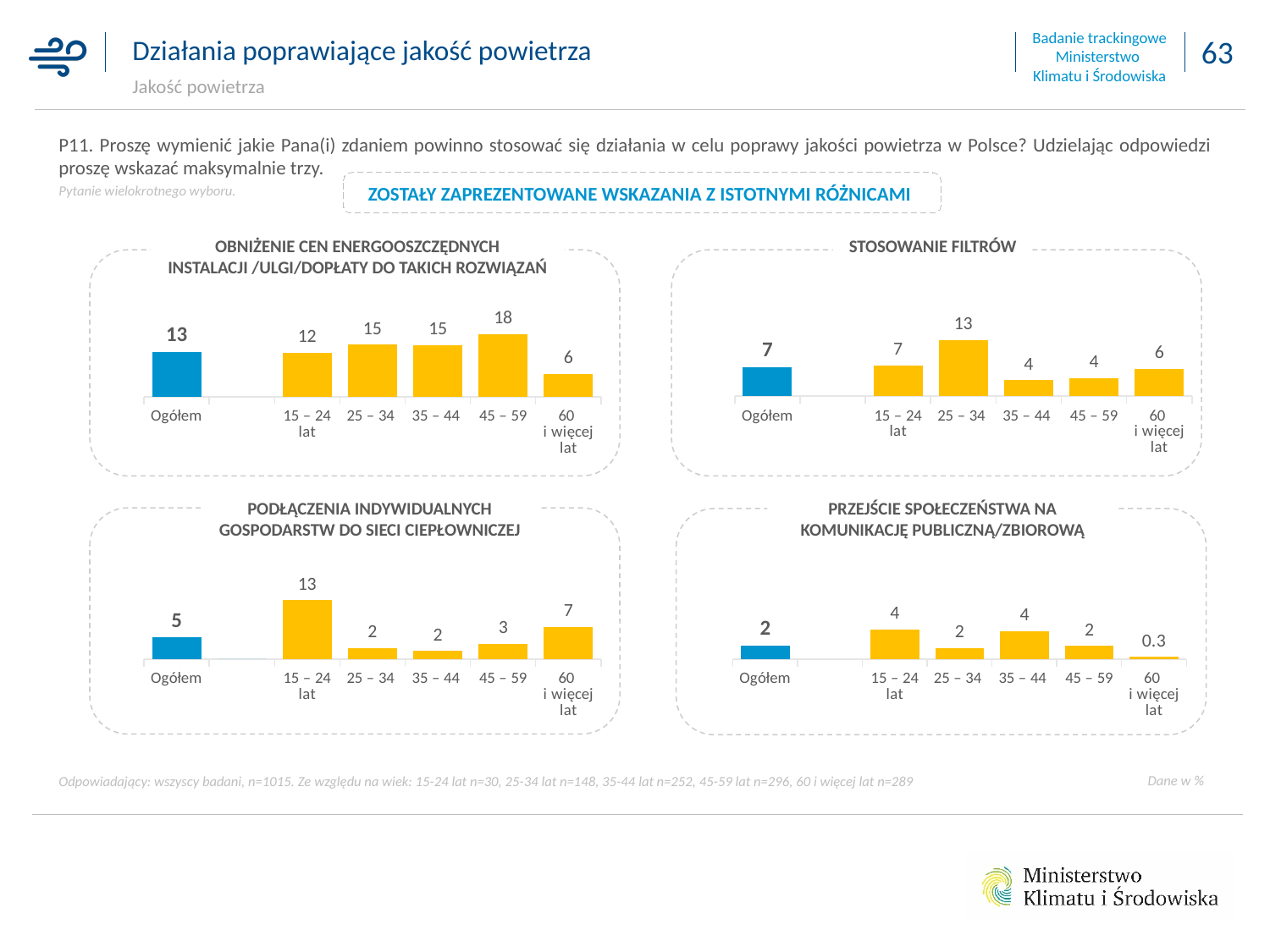
In the chart titled 'STOSOWANIE FILTRÓW', what is the value for '25 – 34'? 13 In the chart titled 'PRZEJŚCIE SPOŁECZEŃSTWA NA KOMUNIKACJĘ PUBLICZNĄ/ZBIOROWĄ', which age group has the lowest value? 60 i więcej lat In the chart titled 'STOSOWANIE FILTRÓW', is the value for '15 – 24 lat' larger or smaller than the value for '60 i więcej lat'? larger In the chart titled 'OBNIŻENIE CEN ENERGOOSZCZĘDNYCH INSTALACJI /ULGI/DOPŁATY DO TAKICH ROZWIĄZAŃ', what is the value for 'Ogółem'? 13 In the chart titled 'OBNIŻENIE CEN ENERGOOSZCZĘDNYCH INSTALACJI /ULGI/DOPŁATY DO TAKICH ROZWIĄZAŃ', which age group has the highest value? 45 – 59 In the chart titled 'PODŁĄCZENIA INDYWIDUALNYCH GOSPODARSTW DO SIECI CIEPŁOWNICZEJ', what is the difference between the values for '15 – 24 lat' and 'Ogółem'? 8 What type of chart is used in the chart titled 'PODŁĄCZENIA INDYWIDUALNYCH GOSPODARSTW DO SIECI CIEPŁOWNICZEJ'? Bar chart In the chart titled 'PODŁĄCZENIA INDYWIDUALNYCH GOSPODARSTW DO SIECI CIEPŁOWNICZEJ', what is the value for '15 – 24 lat'? 13 In the chart titled 'STOSOWANIE FILTRÓW', which age group has the highest value? 25 – 34 In the chart titled 'OBNIŻENIE CEN ENERGOOSZCZĘDNYCH INSTALACJI /ULGI/DOPŁATY DO TAKICH ROZWIĄZAŃ', what is the difference between the values for '45 – 59' and '60 i więcej lat'? 12 In the chart titled 'PRZEJŚCIE SPOŁECZEŃSTWA NA KOMUNIKACJĘ PUBLICZNĄ/ZBIOROWĄ', what is the value for '60 i więcej lat'? 0.3 How many bars are shown in the chart titled 'STOSOWANIE FILTRÓW'? 6